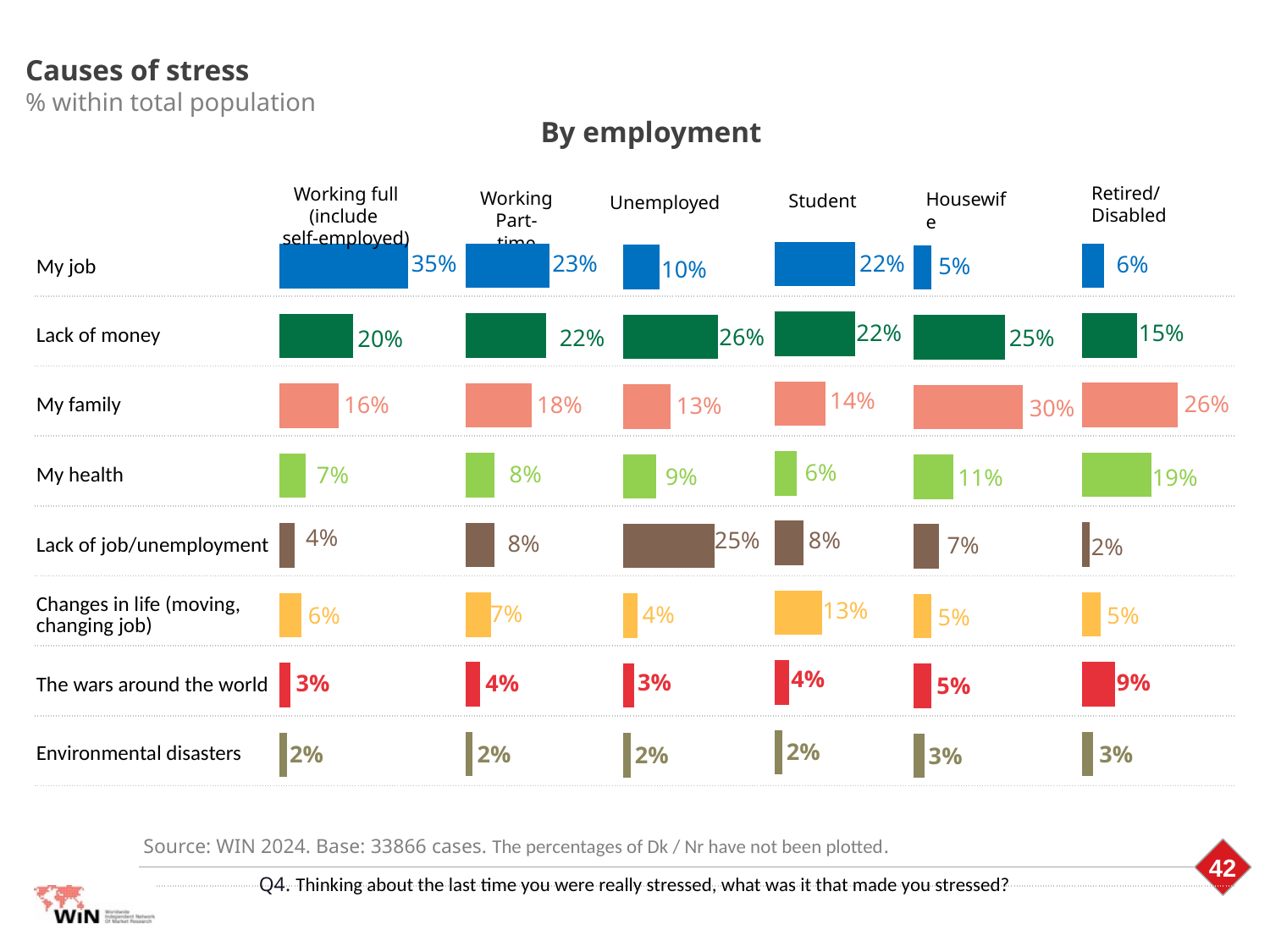
Which employment group has the highest value for "My job"? Working full (include self-employed) What percentage of Housewives cite "My family" as a cause of stress? 30% What is the subtitle shown above the chart grid? By employment Which is larger for Students: "My job" or "Changes in life (moving, changing job)"? My job What type of chart is used on this slide? Bar chart How many causes of stress are listed in the chart? 8 What is the difference between the "Lack of money" values for the Unemployed and the Retired/Disabled? 11% What is the value for "My health" in the Retired/Disabled group? 19% What percentage of those working full time (include self-employed) cite "My job" as a cause of stress? 35% How many employment groups are shown in the chart? 6 What is the value for "Lack of job/unemployment" among the Unemployed? 25% Which employment group has the lowest value for "Lack of job/unemployment"? Retired/Disabled